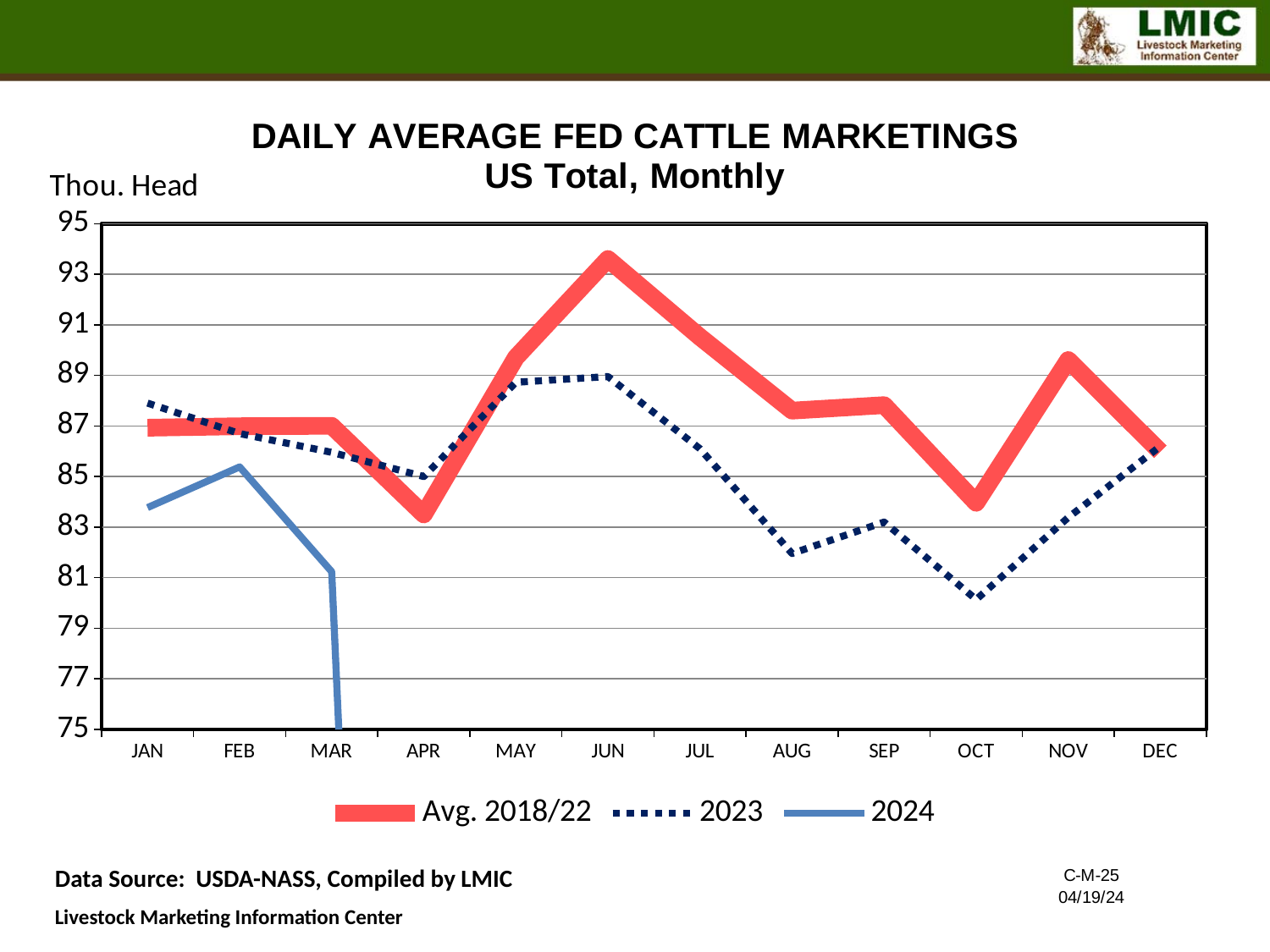
Is the 2023 value for OCT greater or less than 81? less What kind of chart is shown on the slide? line chart How many months are shown along the x axis? 12 Is the 2024 value for MAR greater or less than 83? less In AUG, which series has the larger value, Avg. 2018/22 or 2023? Avg. 2018/22 What unit is shown on the y axis label? Thou. Head In which month does the Avg. 2018/22 series reach its lowest value? APR Is the Avg. 2018/22 value for JUN greater or less than 91? greater In which month does the Avg. 2018/22 series reach its highest value? JUN How many series does the legend list? 3 Does the 2024 series rise or fall from FEB to MAR? fall In which month does the 2023 series reach its lowest value? OCT